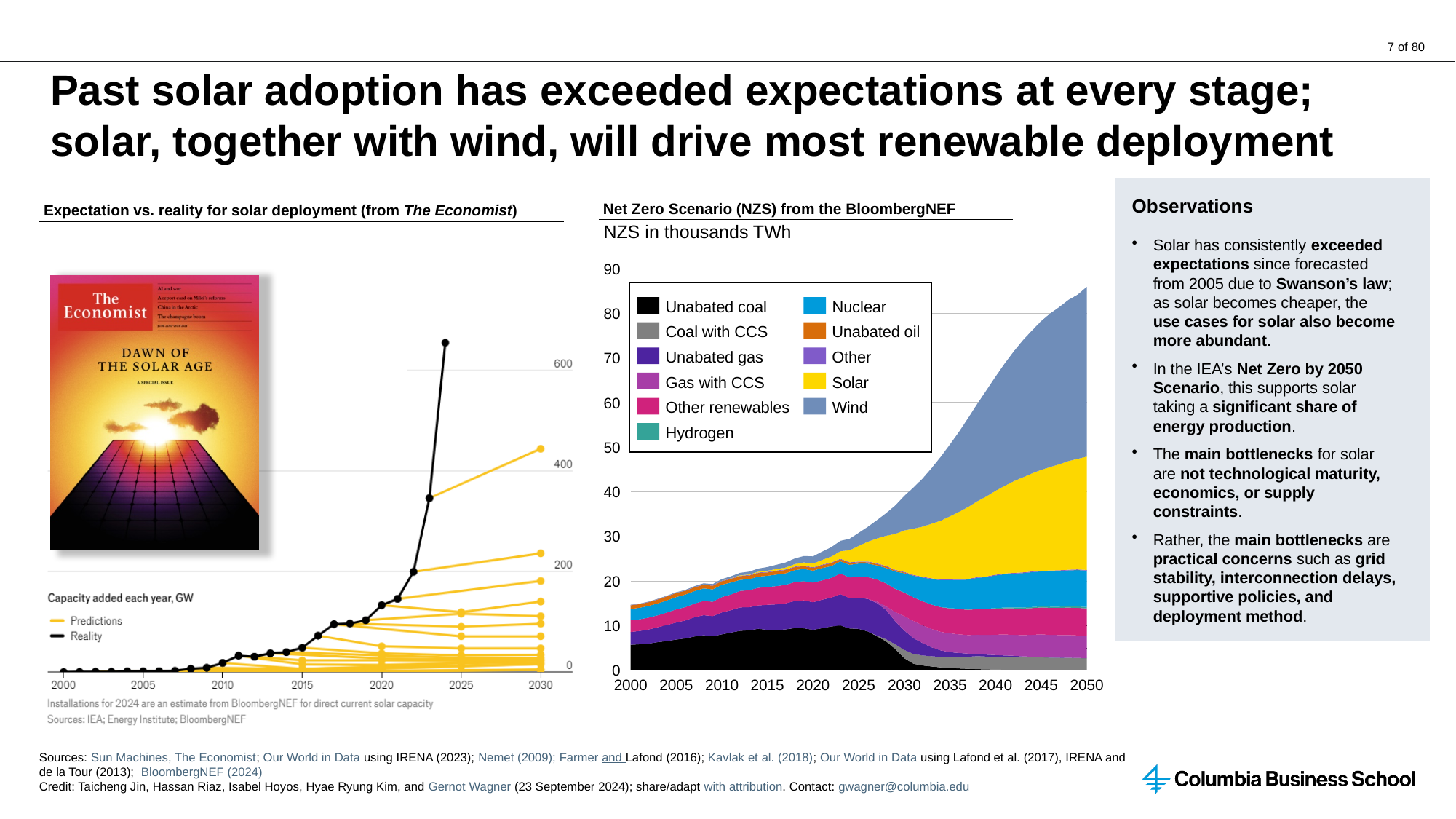
In the Expectation vs. reality for solar deployment chart, does the Reality series rise or fall from 2000 to 2024? Rises In the Net Zero Scenario (NZS) chart, which series has the largest value in 2050? Wind In the Expectation vs. reality for solar deployment chart, is the Reality value for 2020 greater or less than 200? less In the Net Zero Scenario (NZS) chart, is the total stacked value in 2050 greater or less than 80? greater What kind of chart is the Net Zero Scenario (NZS) from the BloombergNEF chart? Stacked area chart In the Expectation vs. reality for solar deployment chart, which series is higher in 2024, Predictions or Reality? Reality How many series does the legend of the Expectation vs. reality for solar deployment chart list? 2 In the Net Zero Scenario (NZS) chart, does the total stacked value rise or fall from 2000 to 2050? Rises How many series does the legend of the Net Zero Scenario (NZS) chart list? 11 In the Net Zero Scenario (NZS) chart, is the total stacked value in 2000 greater or less than 20? less What unit is shown on the y axis of the Net Zero Scenario (NZS) chart? Thousands TWh